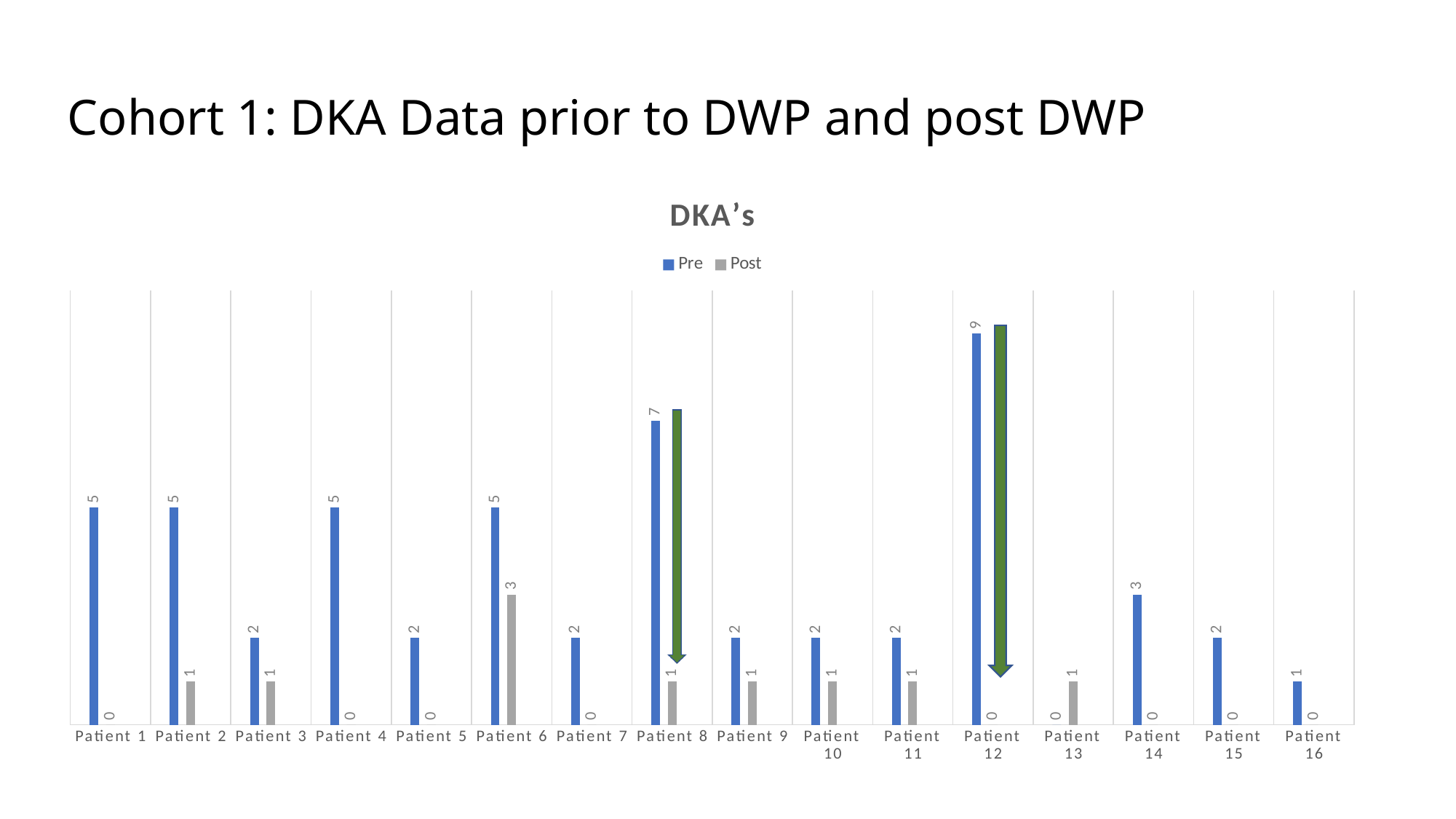
What is the difference between the Pre and Post values for Patient 8? 6 Which patient has the highest Post value? Patient 6 What is the Post value for Patient 13? 1 How many patients are shown on the x axis? 16 What is the title of the chart? DKA’s What is the Pre value for Patient 12? 9 What is the Pre value for Patient 8? 7 How many series does the legend list? 2 What kind of chart is shown? Bar chart Which is larger for Patient 14, the Pre value or the Post value? Pre Which patient has the highest Pre value? Patient 12 What is the Post value for Patient 6? 3